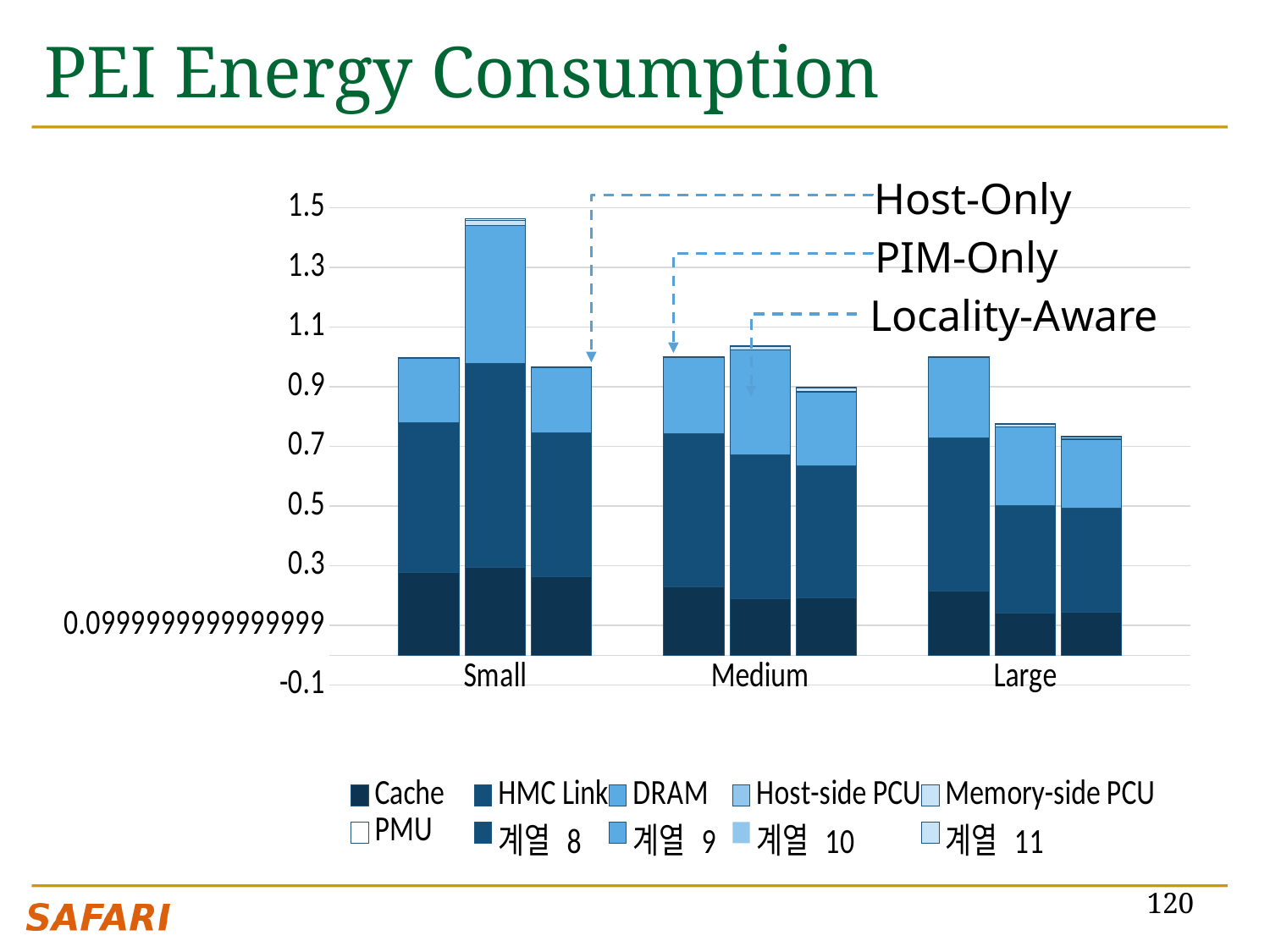
Is the total for the PIM-Only bar in the Small category greater or less than 1.3? greater Which three configurations are labeled by the dashed arrows on the chart? Host-Only, PIM-Only, Locality-Aware How many categories are shown on the x axis? 3 In the Large category, which bar is taller: Host-Only or PIM-Only? Host-Only In the Small category, which bar is taller: Host-Only or PIM-Only? PIM-Only Is the total for the PIM-Only bar in the Medium category greater or less than 0.9? greater Do the Locality-Aware bars rise or fall from Small to Large? fall What kind of chart is shown on the slide? stacked bar chart Which category contains the tallest bar in the chart? Small How many series does the legend list? 10 Is the total for the Locality-Aware bar in the Large category greater or less than 0.9? less What is the title of the chart? PEI Energy Consumption